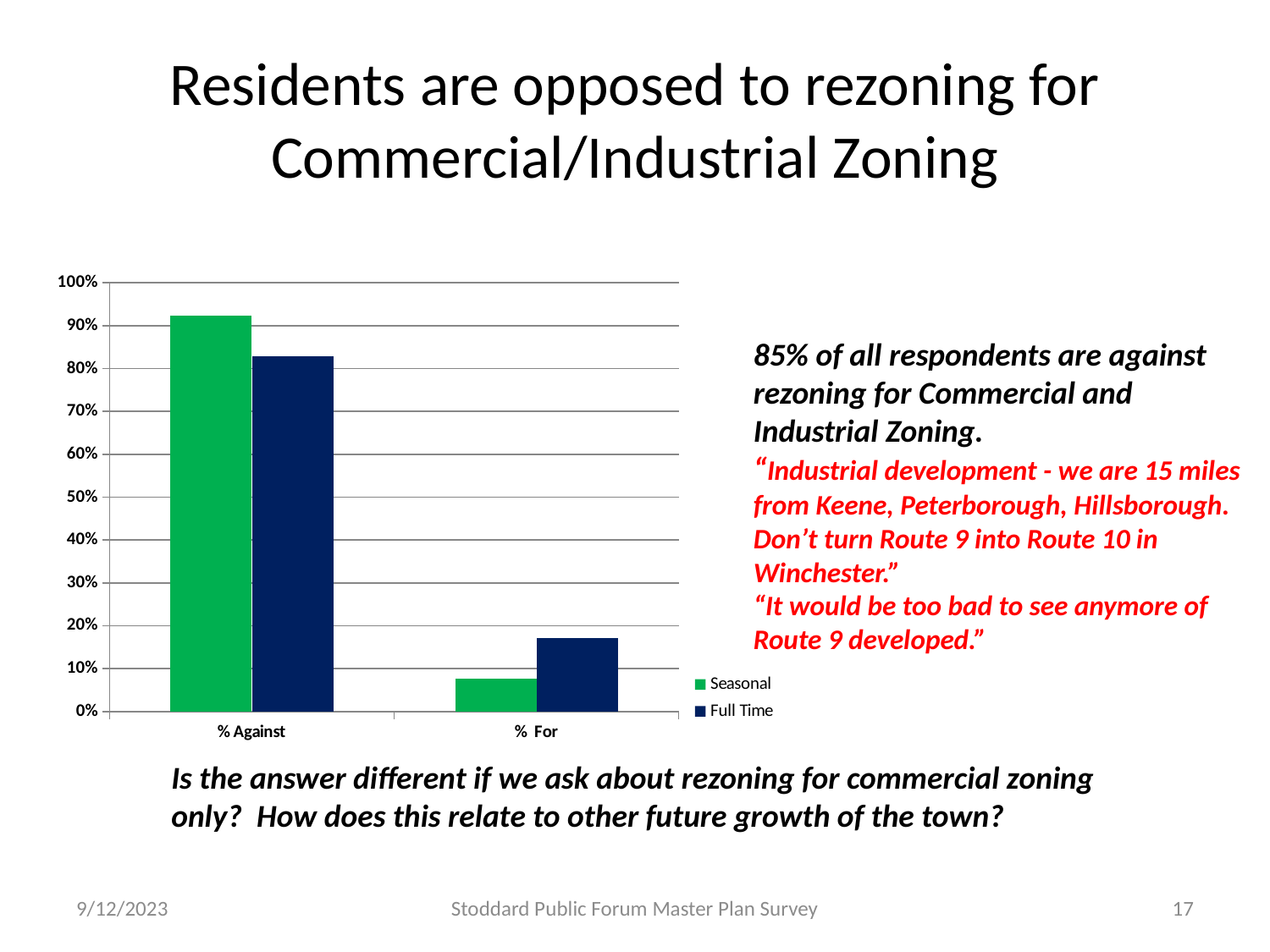
Is the Full Time value for % Against greater or less than 80%? greater Which category has the shortest bar in the chart? % For Which series is shown in dark blue in the chart? Full Time For the % For category, which series has the larger value, Seasonal or Full Time? Full Time What kind of chart is shown on the slide? bar chart How many series does the chart's legend list? 2 Is the Seasonal value for % Against greater or less than 90%? greater Is the Seasonal value for % For greater or less than 10%? less Which series is shown in green in the chart? Seasonal For the % Against category, which series has the larger value, Seasonal or Full Time? Seasonal How many categories are shown on the x axis of the chart? 2 Which category has the tallest bar in the chart? % Against